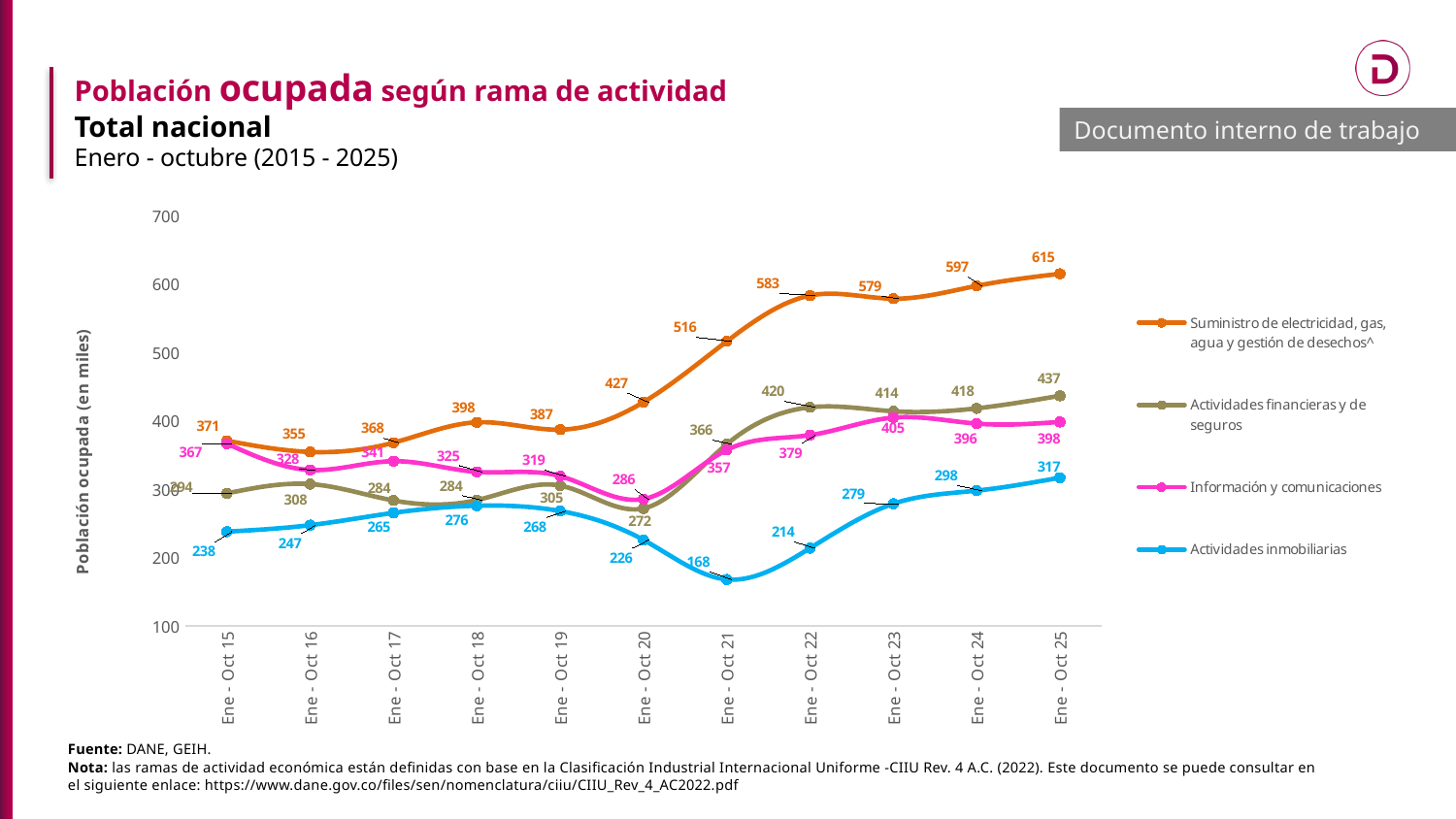
Does the Suministro de electricidad, gas, agua y gestión de desechos series generally rise or fall from Ene - Oct 19 to Ene - Oct 25? rise How many series does the legend list? 4 In which period does Actividades inmobiliarias reach its lowest value? Ene - Oct 21 What is the value for Suministro de electricidad, gas, agua y gestión de desechos in Ene - Oct 25? 615 Which series has the higher value in Ene - Oct 20: Actividades financieras y de seguros or Información y comunicaciones? Información y comunicaciones In which period does Suministro de electricidad, gas, agua y gestión de desechos reach its highest value? Ene - Oct 25 What is the value for Información y comunicaciones in Ene - Oct 23? 405 What is the value for Actividades financieras y de seguros in Ene - Oct 22? 420 What is the value for Actividades inmobiliarias in Ene - Oct 21? 168 How many periods are shown on the x axis? 11 What type of chart is shown on the slide? line chart What is the difference between the Suministro de electricidad, gas, agua y gestión de desechos values in Ene - Oct 25 and Ene - Oct 15? 244